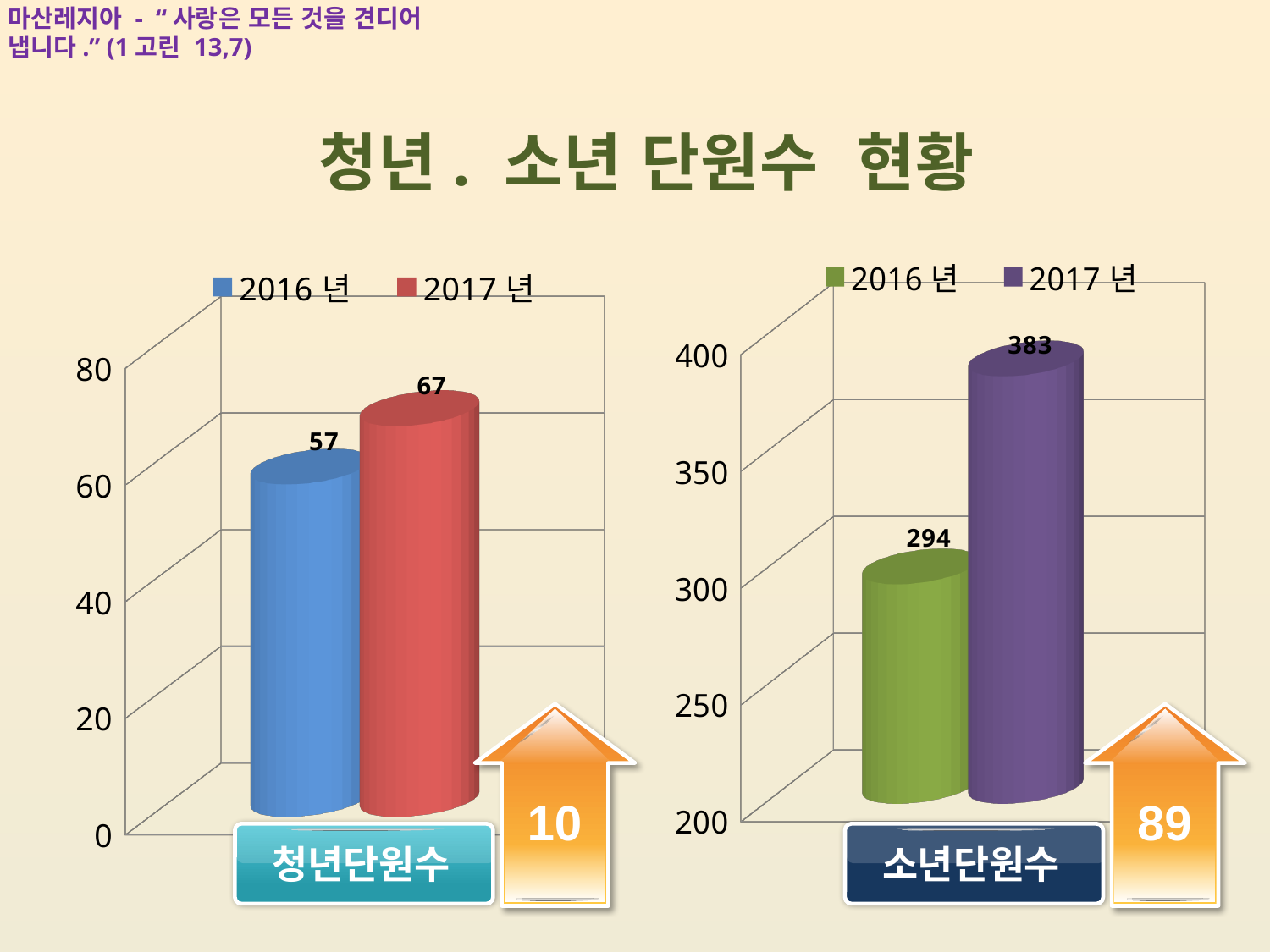
In the left chart (청년단원수), what is the difference between the 2017 년 and 2016 년 values? 10 In the right chart (소년단원수), what colour is the bar for 2017 년? purple In the left chart (청년단원수), what is the value for 2017 년? 67 In the right chart (소년단원수), what is the value for 2017 년? 383 In the right chart (소년단원수), what is the difference between the 2017 년 and 2016 년 values? 89 How many series does the legend of the left chart (청년단원수) list? 2 In the left chart (청년단원수), what is the value for 2016 년? 57 What kind of chart is the right chart (소년단원수)? bar chart In the right chart (소년단원수), is the value for 2016 년 larger or smaller than the value for 2017 년? smaller In the right chart (소년단원수), which year has the lower value? 2016 년 In the right chart (소년단원수), what is the value for 2016 년? 294 In the left chart (청년단원수), which year has the higher value? 2017 년